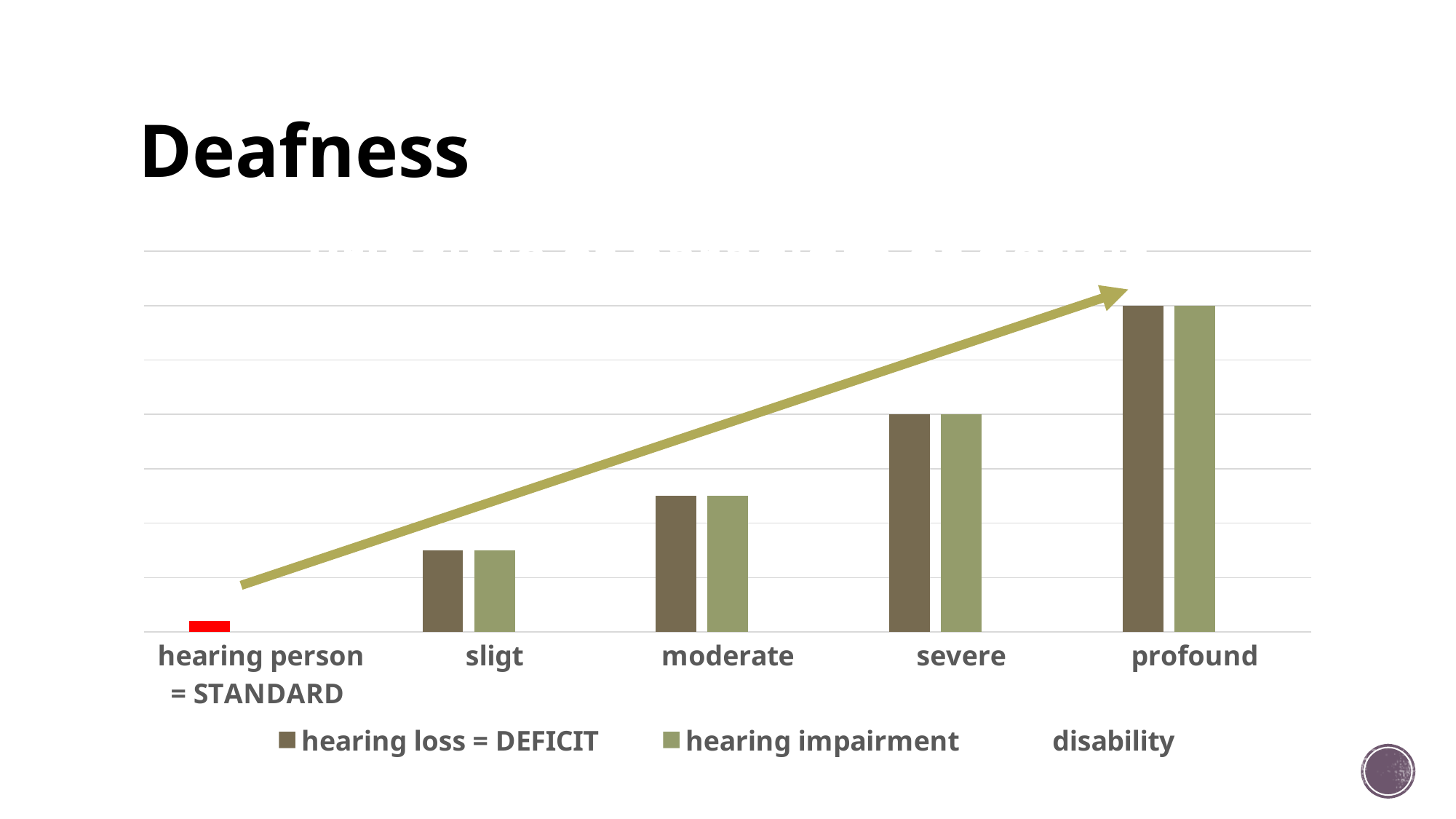
How many series does the chart's legend list? 3 Which category has the lowest bar in the chart? hearing person = STANDARD What is the first series listed in the chart's legend? hearing loss = DEFICIT Do the bar values rise or fall moving from left to right along the x axis? rise Which category has a larger value for hearing loss = DEFICIT, severe or moderate? severe Which category has a larger value for hearing impairment, sligt or profound? profound What is the title of the slide containing the chart? Deafness Which category has the tallest bars in the chart? profound How many categories are shown along the x axis of the chart? 5 What kind of chart is shown on the slide? bar chart